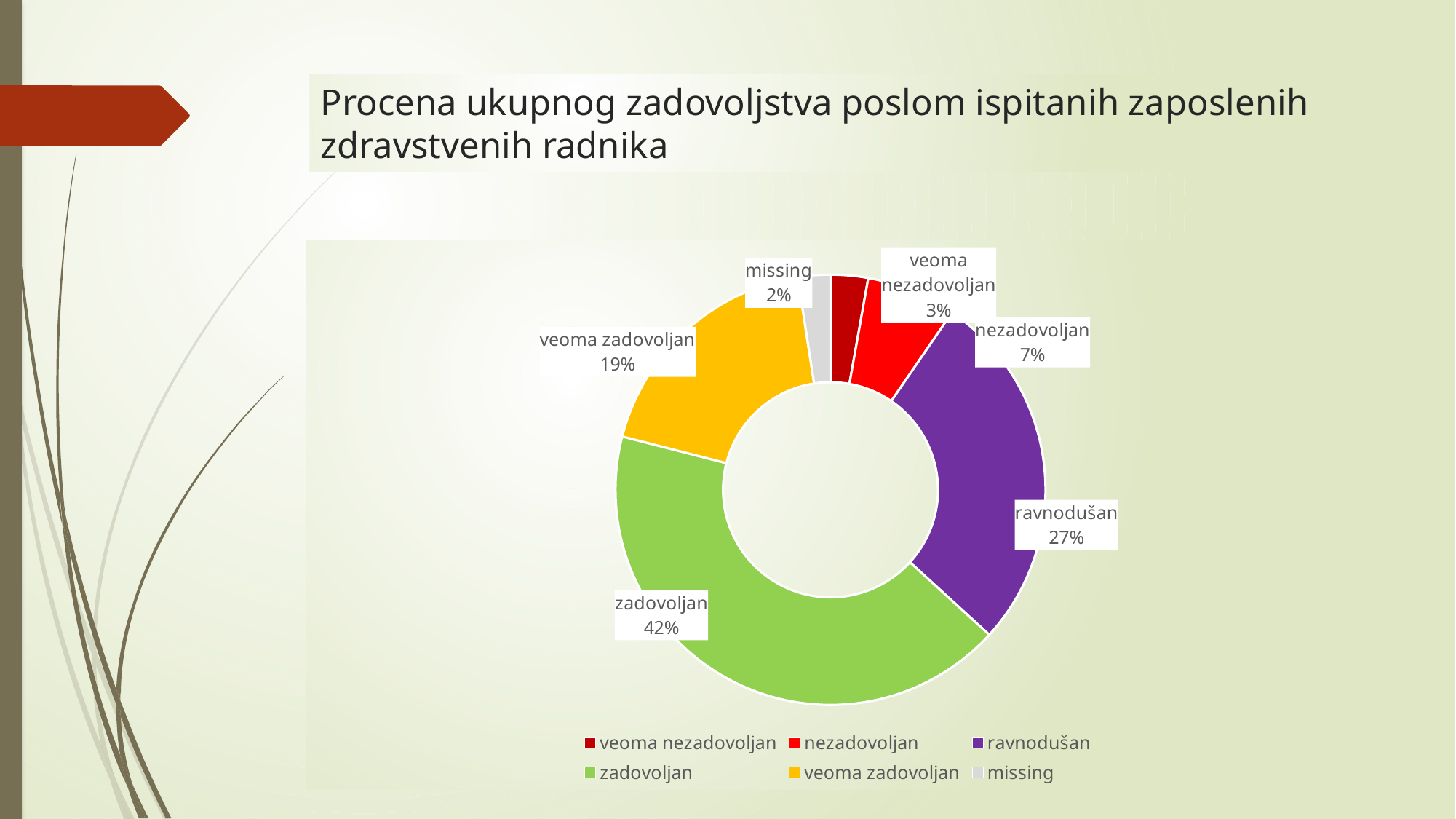
What percentage of respondents are 'zadovoljan'? 42% Which category has the largest share of the chart? zadovoljan Which is larger, the share for 'nezadovoljan' or the share for 'veoma zadovoljan'? veoma zadovoljan What percentage is shown for 'veoma nezadovoljan'? 3% What type of chart is shown on the slide? Doughnut (pie) chart What is the difference in percentage points between 'zadovoljan' and 'ravnodušan'? 15% What is the combined share of 'veoma nezadovoljan' and 'nezadovoljan'? 10% What percentage is shown for 'veoma zadovoljan'? 19% How many categories are shown in the chart? 6 What percentage of respondents are 'ravnodušan'? 27% Which category has the smallest share of the chart? missing What colour represents 'ravnodušan' in the chart? Purple